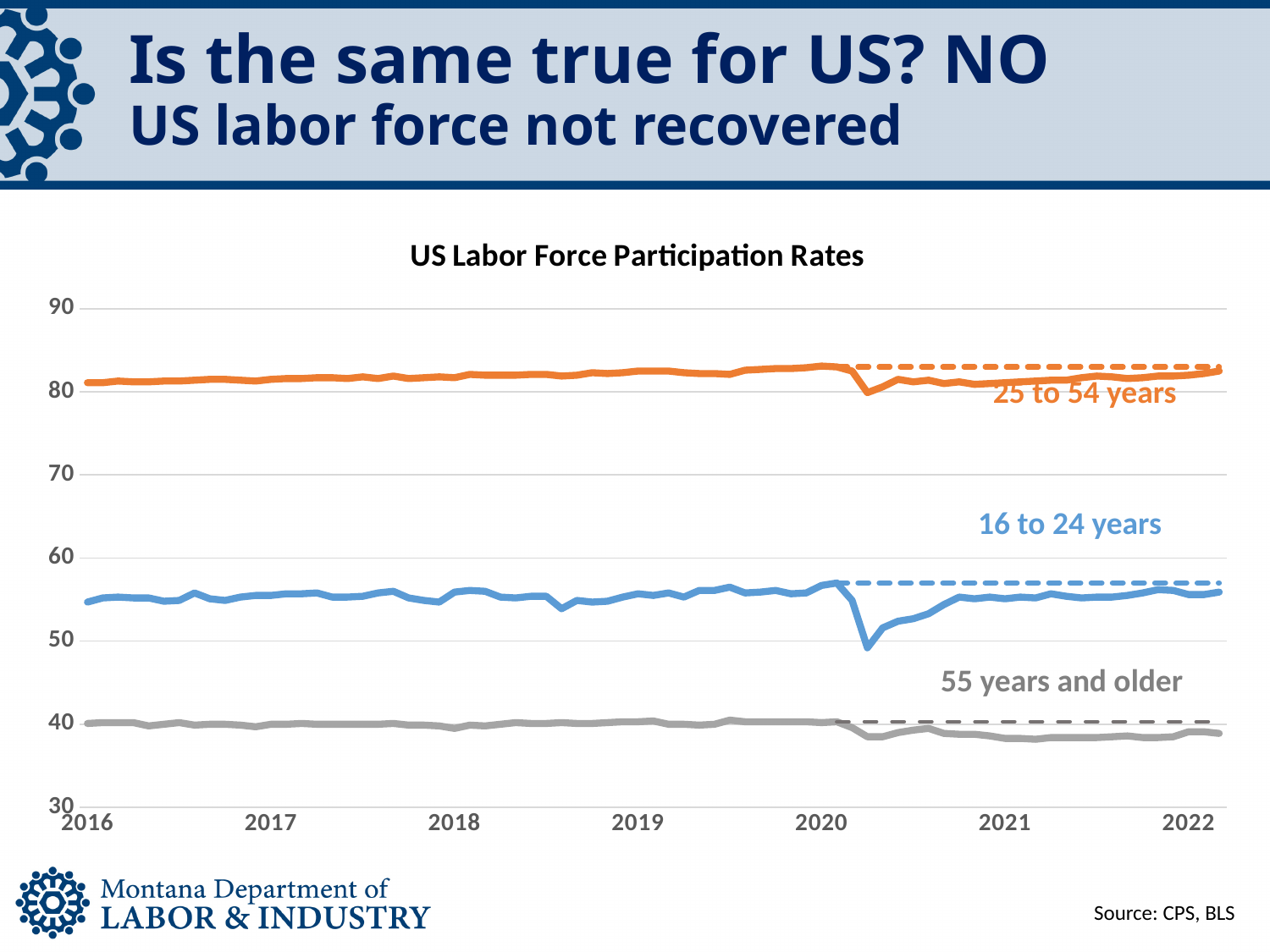
Is the participation rate for 16 to 24 years at the start of 2016 greater or less than 60? less Which age group has the lowest labor force participation rate throughout the chart? 55 years and older How many age-group series are plotted in the US Labor Force Participation Rates chart? 3 Does the participation rate for 55 years and older rise or fall between 2020 and 2022? fall Which is higher in 2021: the participation rate for 25 to 54 years or for 16 to 24 years? 25 to 54 years Is the participation rate for 25 to 54 years at the start of 2016 greater or less than 80? greater What is the title of the chart? US Labor Force Participation Rates Is the participation rate for 16 to 24 years in 2019 greater or less than 50? greater How many year labels are shown on the x axis? 7 Which age group has the highest labor force participation rate throughout the chart? 25 to 54 years What kind of chart is shown on the slide? line chart